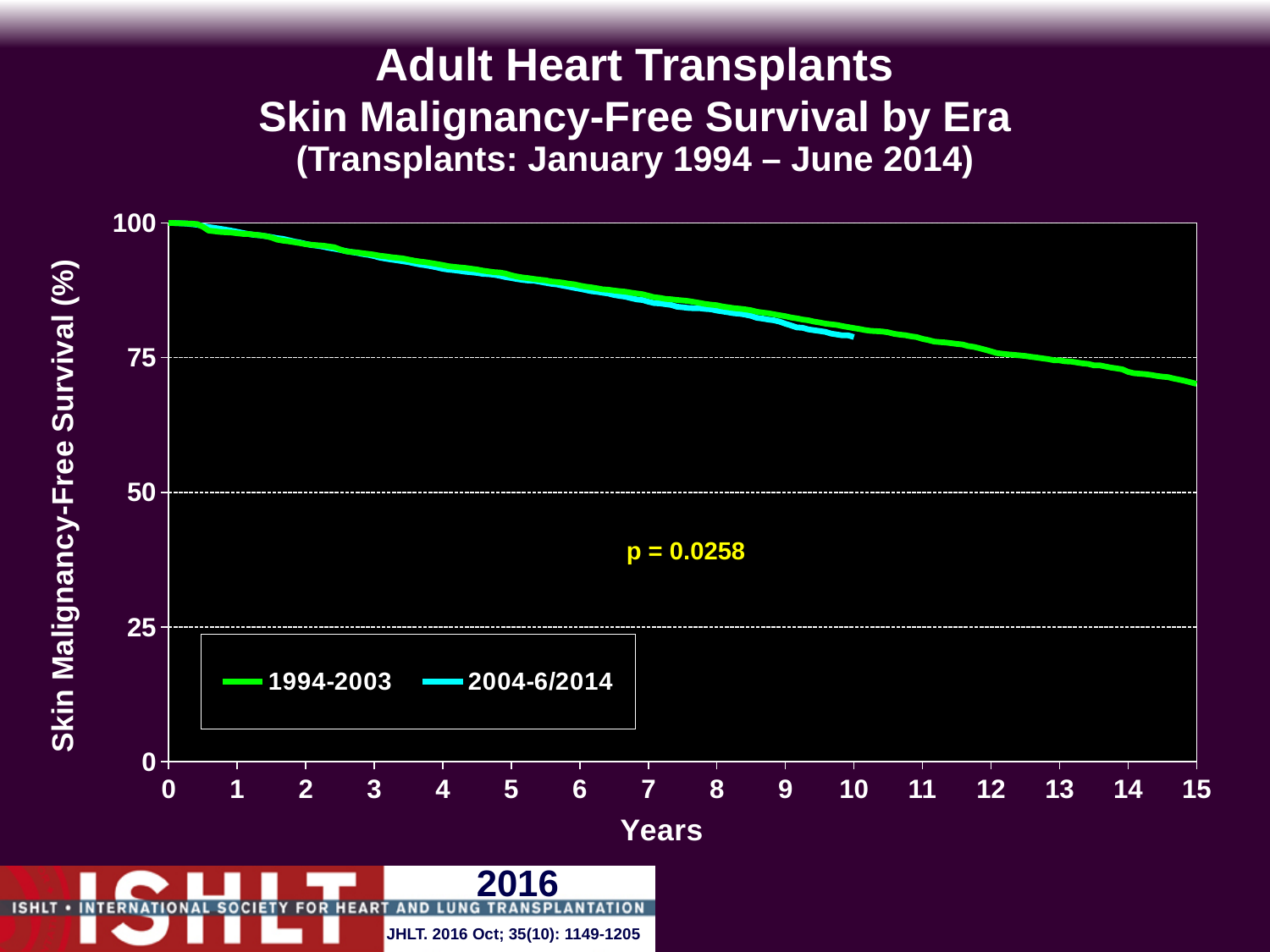
Which series extends further along the x axis, 1994-2003 or 2004-6/2014? 1994-2003 How many series does the legend list? 2 Is the value for the 1994-2003 series at 10 years greater or less than 75? greater What are the two series named in the legend? 1994-2003 and 2004-6/2014 What p-value is printed on the chart? p = 0.0258 What is the title of the chart? Adult Heart Transplants Skin Malignancy-Free Survival by Era (Transplants: January 1994 – June 2014) What is the label of the x axis? Years Is the value for the 2004-6/2014 series at 5 years greater or less than 75? greater Is the value for the 1994-2003 series at 2 years greater or less than 90? greater What kind of chart is shown on the slide? line chart Do the survival curves rise or fall as the years increase? fall